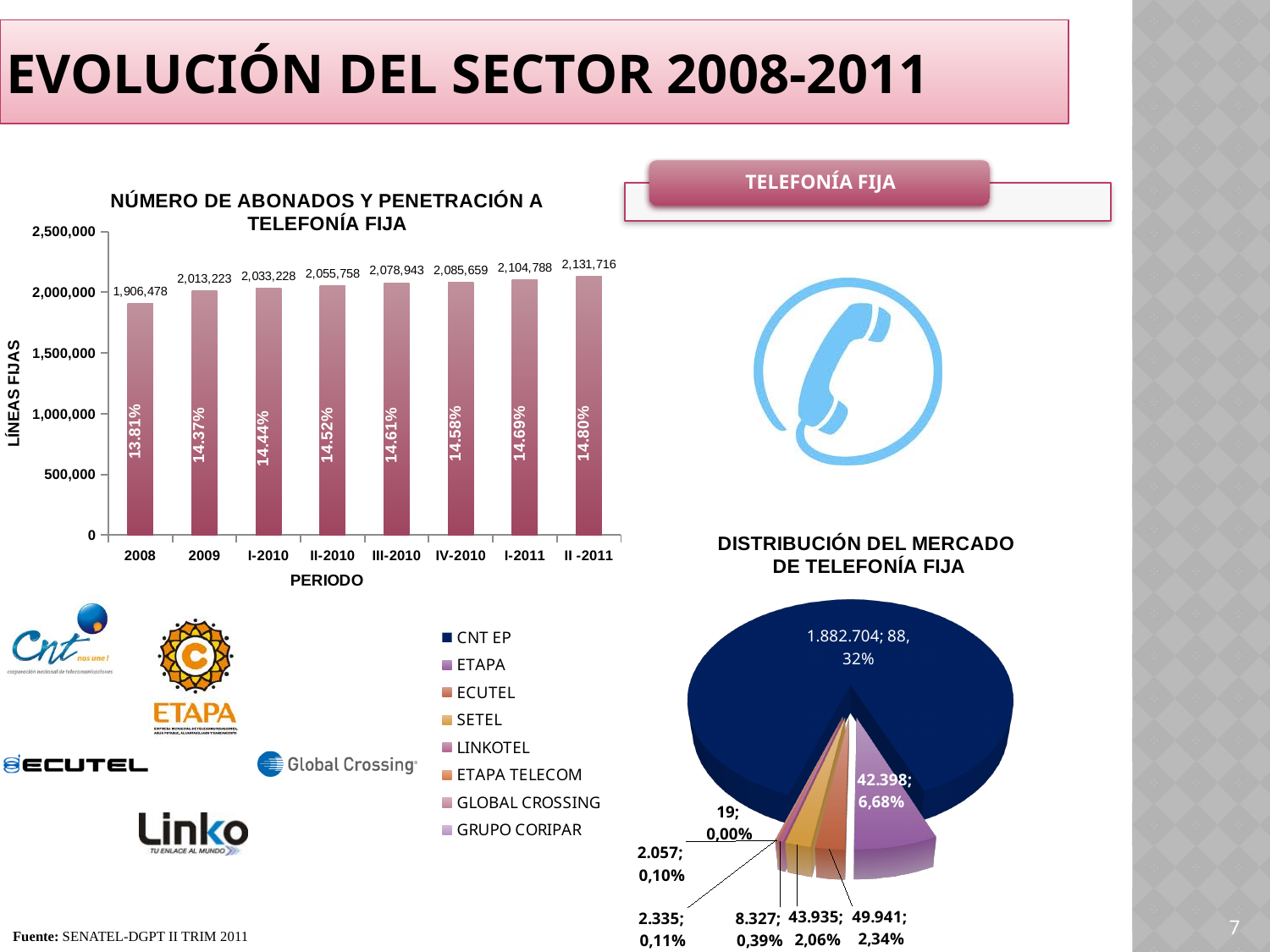
In the pie chart 'DISTRIBUCIÓN DEL MERCADO DE TELEFONÍA FIJA', what share does the largest slice have? 88,32% In the bar chart 'NÚMERO DE ABONADOS Y PENETRACIÓN A TELEFONÍA FIJA', how many fixed lines are shown for 2008? 1,906,478 In the bar chart 'NÚMERO DE ABONADOS Y PENETRACIÓN A TELEFONÍA FIJA', what is the difference in fixed lines between II -2011 and 2008? 225,238 In the bar chart 'NÚMERO DE ABONADOS Y PENETRACIÓN A TELEFONÍA FIJA', which period has the highest number of fixed lines? II -2011 In the bar chart 'NÚMERO DE ABONADOS Y PENETRACIÓN A TELEFONÍA FIJA', do the number of fixed lines rise or fall from 2008 to II -2011? rise How many periods are shown on the x axis of the bar chart 'NÚMERO DE ABONADOS Y PENETRACIÓN A TELEFONÍA FIJA'? 8 How many entries does the legend of the pie chart 'DISTRIBUCIÓN DEL MERCADO DE TELEFONÍA FIJA' list? 8 In the bar chart 'NÚMERO DE ABONADOS Y PENETRACIÓN A TELEFONÍA FIJA', which period has more fixed lines, IV-2010 or I-2011? I-2011 In the bar chart 'NÚMERO DE ABONADOS Y PENETRACIÓN A TELEFONÍA FIJA', what penetration percentage is shown for II -2011? 14.80% In the bar chart 'NÚMERO DE ABONADOS Y PENETRACIÓN A TELEFONÍA FIJA', which period has the lowest number of fixed lines? 2008 What kind of chart is 'NÚMERO DE ABONADOS Y PENETRACIÓN A TELEFONÍA FIJA'? bar chart In the bar chart 'NÚMERO DE ABONADOS Y PENETRACIÓN A TELEFONÍA FIJA', is the value for 2009 greater or less than 2,000,000? greater